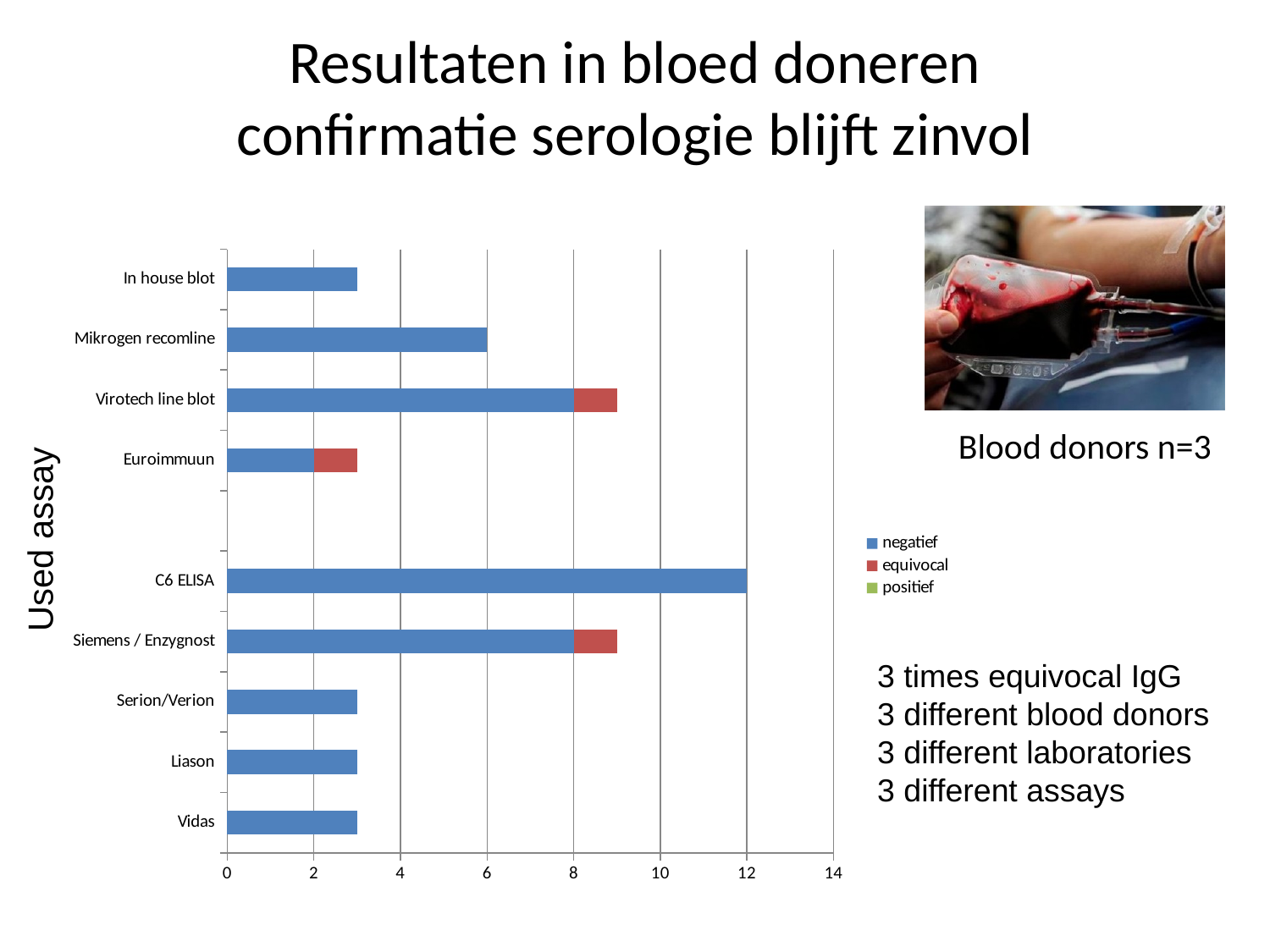
What is the value for C6 ELISA? 12 Is the value for In house blot greater or less than 4? less Is the value for Vidas greater or less than 2? greater How many series does the legend list? 3 What is the negatief value for Euroimmuun? 2 What is the difference between the values for C6 ELISA and Mikrogen recomline? 6 What is the negatief value for Virotech line blot? 8 Which assay has the highest value in the chart? C6 ELISA What kind of chart is shown on the slide? bar chart What is the title of the vertical axis of the chart? Used assay Which is larger, the value for C6 ELISA or the value for Siemens / Enzygnost? C6 ELISA What is the value for Mikrogen recomline? 6